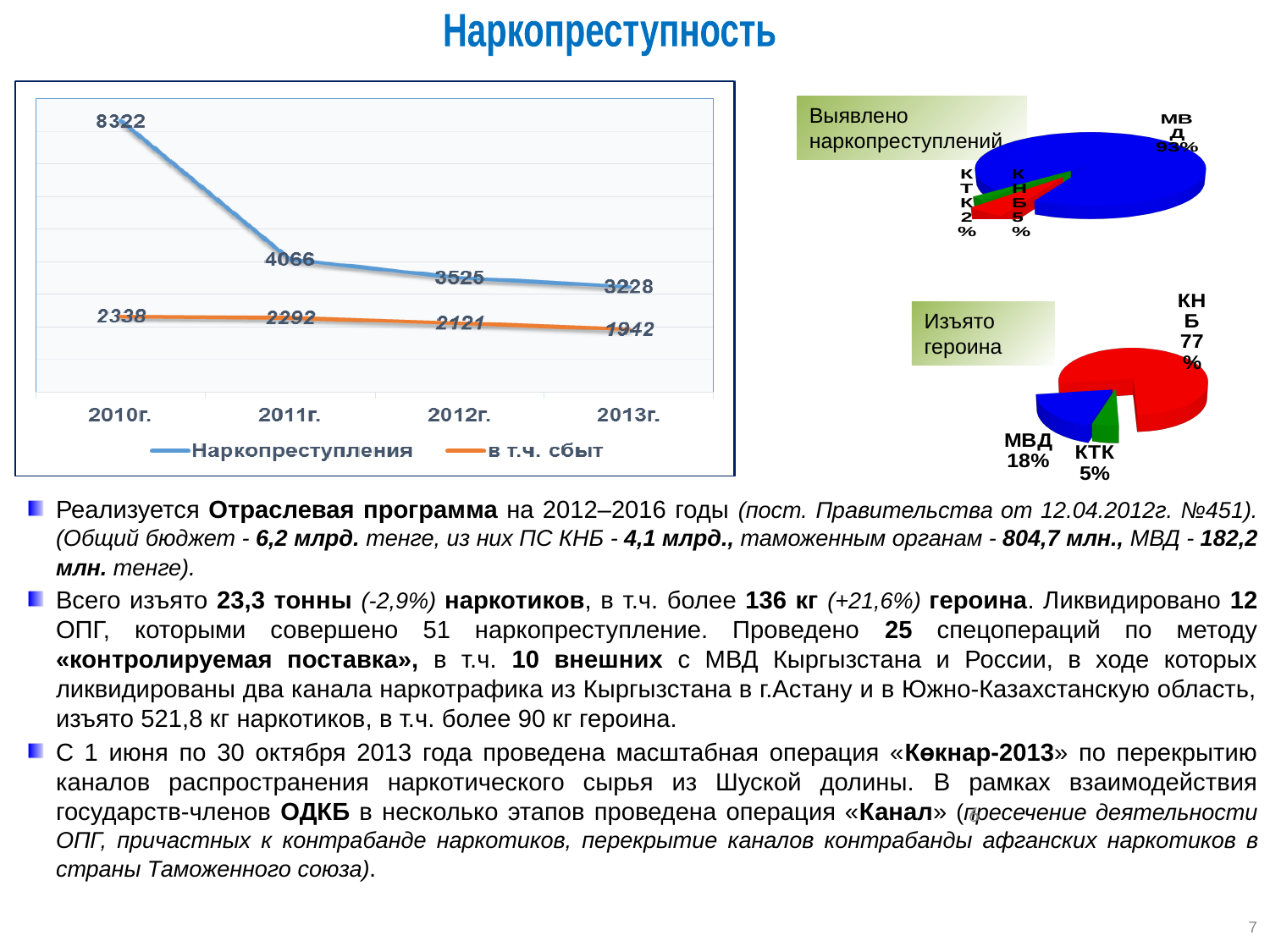
In the line chart on the left, how does the Наркопреступления series change from 2010г. to 2013г.? It falls What type of chart is the chart on the left of the slide? Line chart In the pie chart titled Выявлено наркопреступлений, what share does МВД have? 93% In the line chart on the left, which year has the lowest value for в т.ч. сбыт? 2013г. In the line chart on the left, what is the value of Наркопреступления for 2010г.? 8322 In the line chart on the left, what is the difference between Наркопреступления in 2010г. and 2011г.? 4256 In the line chart on the left, what is the value of Наркопреступления for 2012г.? 3525 In the line chart on the left, how many series does the legend list? 2 In the pie chart titled Изъято героина, which category has the largest share? КНБ In the line chart on the left, how many years are shown on the x axis? 4 In the line chart on the left, which year has the highest value for Наркопреступления? 2010г. In the line chart on the left, what is the value of в т.ч. сбыт for 2013г.? 1942